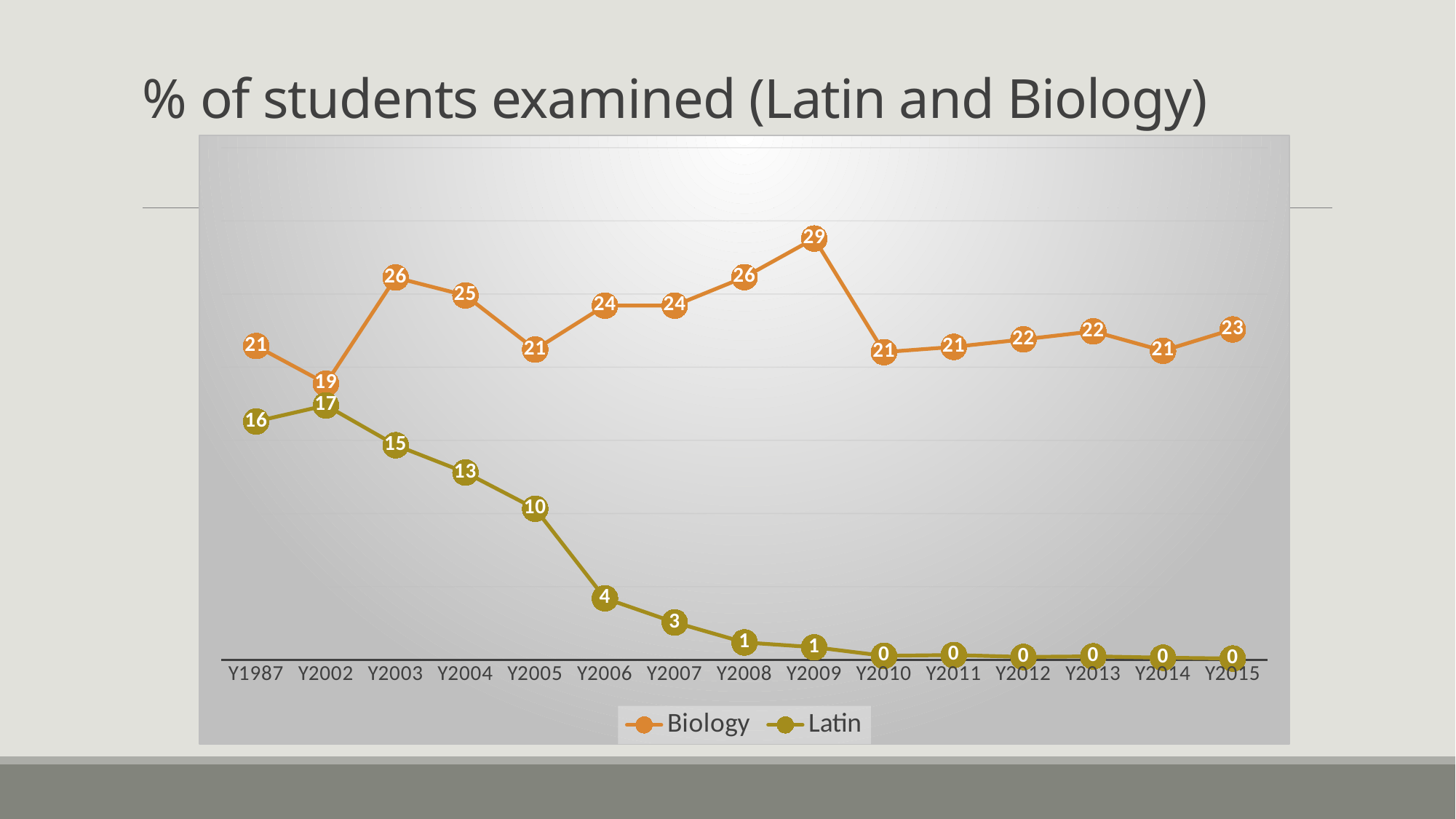
In which year is the Biology value highest? Y2009 In which year is the Biology value lowest? Y2002 Which series has the larger value in Y2002, Biology or Latin? Biology What kind of chart is shown on the slide? Line chart What is the value for Latin in Y2005? 10 What is the value for Biology in Y2009? 29 Does the Latin series generally rise or fall from Y2002 to Y2010? Fall What is the value for Latin in Y1987? 16 How many years are shown on the x axis? 15 How many series does the legend list? 2 What is the difference between the Biology and Latin values in Y2003? 11 What is the title of the chart? % of students examined (Latin and Biology)